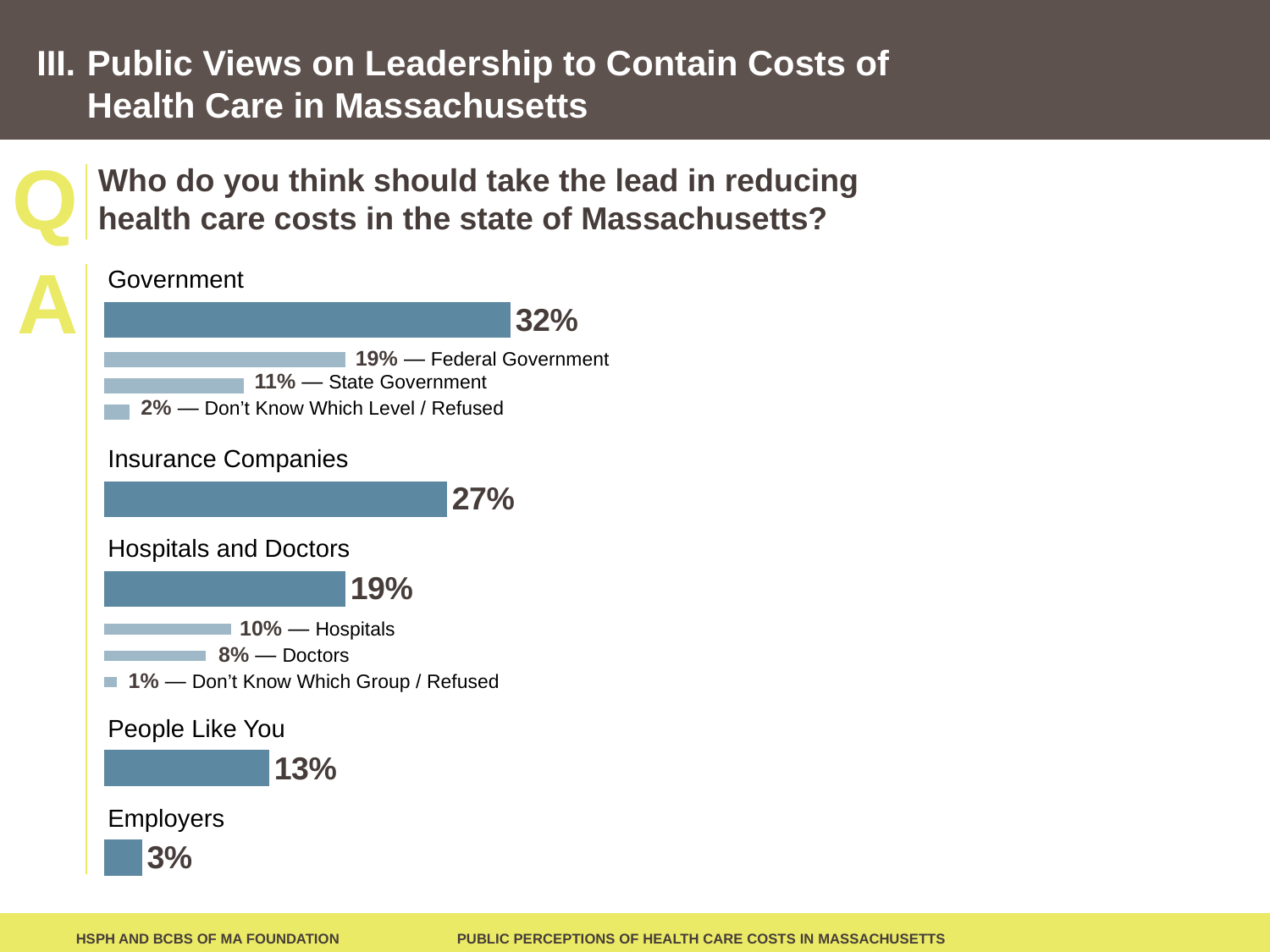
What percentage of respondents said Insurance Companies should take the lead? 27% What percentage of respondents said Government should take the lead in reducing health care costs? 32% How many main categories are shown in the chart? 5 What is the difference in percentage points between Government and Insurance Companies? 5 What kind of chart is shown on the slide? Bar chart What percentage of respondents said the Federal Government should take the lead? 19% What is the difference in percentage points between Hospitals and Doctors within the Hospitals and Doctors category? 2 Which main category has the highest percentage? Government Which main category has the lowest percentage? Employers What percentage of respondents said Employers should take the lead? 3% Which is larger, the percentage for Hospitals and Doctors or the percentage for People Like You? Hospitals and Doctors What percentage of respondents said Doctors should take the lead? 8%